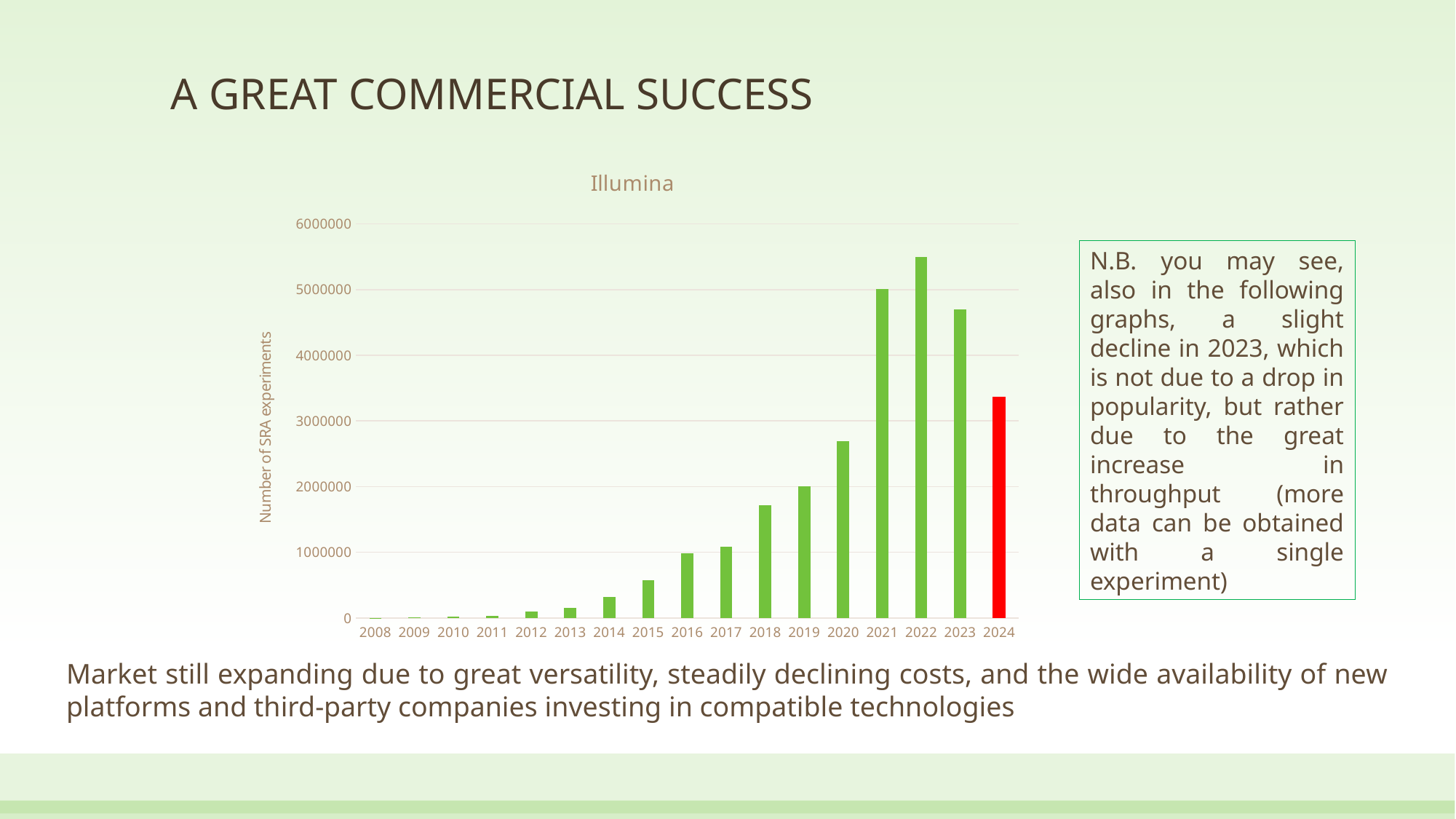
What kind of chart is shown on the slide? bar chart Is the value for 2021 greater or less than 4000000? greater Is the value for 2023 greater or less than 5000000? less Is the value for 2018 greater or less than 2000000? less What is the label of the vertical axis? Number of SRA experiments Which year has the highest number of SRA experiments? 2022 What is the title of the chart? Illumina Which year has the larger value, 2022 or 2023? 2022 How many years are shown on the x axis of the chart? 17 Do the values generally rise or fall from 2008 to 2022? rise